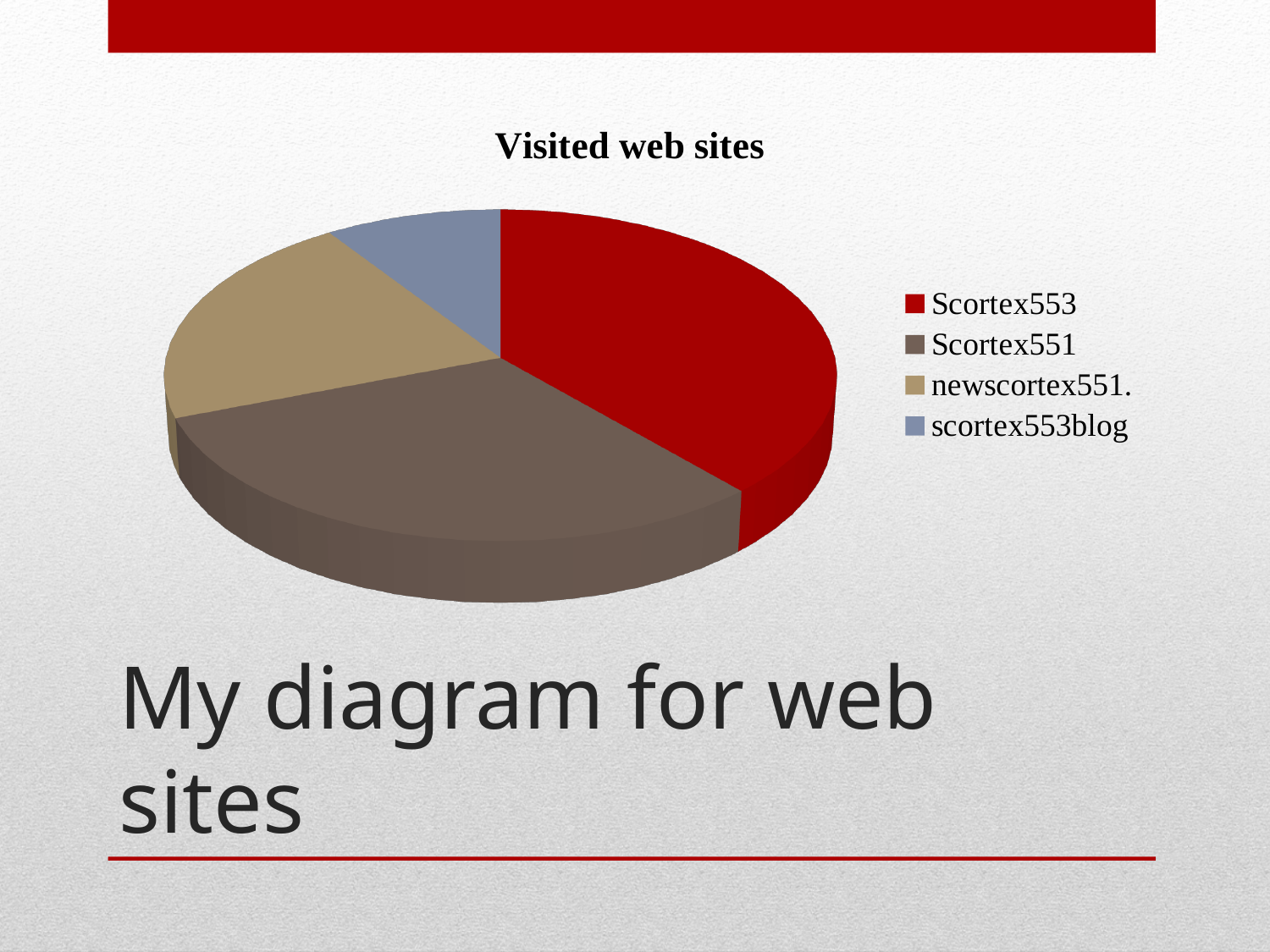
How many entries does the legend list? 4 What kind of chart is shown on the slide? pie chart How many slices does the pie chart have? 4 Which colour represents Scortex553 in the chart? red Which web site has the largest slice of the pie? Scortex553 Which slice is larger, Scortex553 or scortex553blog? Scortex553 Which slice is larger, Scortex551 or newscortex551.? Scortex551 Which slice is larger, newscortex551. or scortex553blog? newscortex551. What is the title of the chart? Visited web sites Which web site has the smallest slice of the pie? scortex553blog